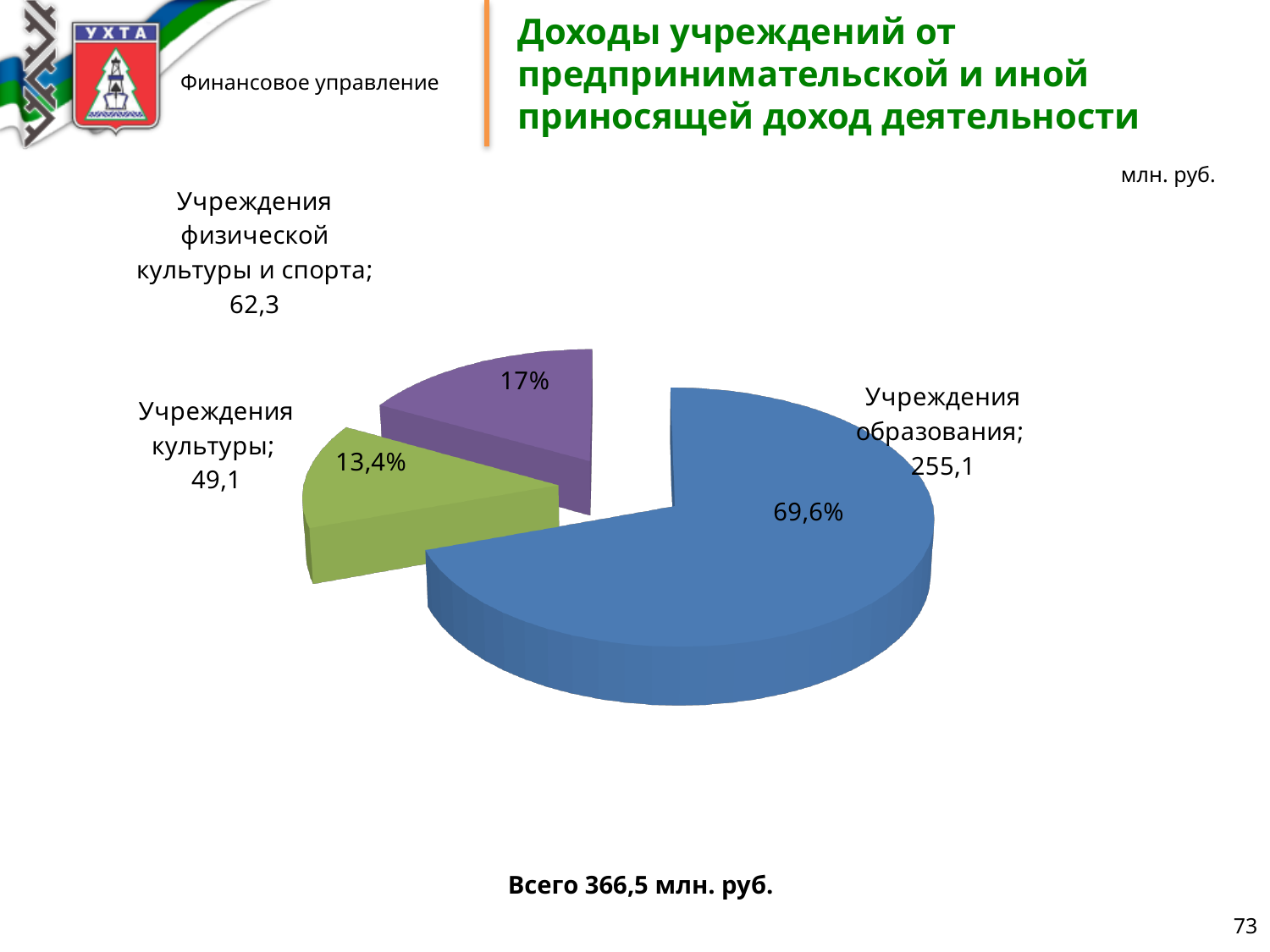
What share of the pie does Учреждения культуры represent? 13,4% What share of the pie does Учреждения образования represent? 69,6% What share of the pie does Учреждения физической культуры и спорта represent? 17% Which category has the smallest slice of the pie? Учреждения культуры What type of chart is shown on the slide? pie chart Which category has the largest slice of the pie? Учреждения образования What is the value for Учреждения культуры? 49,1 What is the value for Учреждения образования? 255,1 What total is stated below the pie chart? 366,5 млн. руб. How many slices does the pie chart have? 3 What is the difference between the values for Учреждения физической культуры и спорта and Учреждения культуры? 13,2 What is the value for Учреждения физической культуры и спорта? 62,3